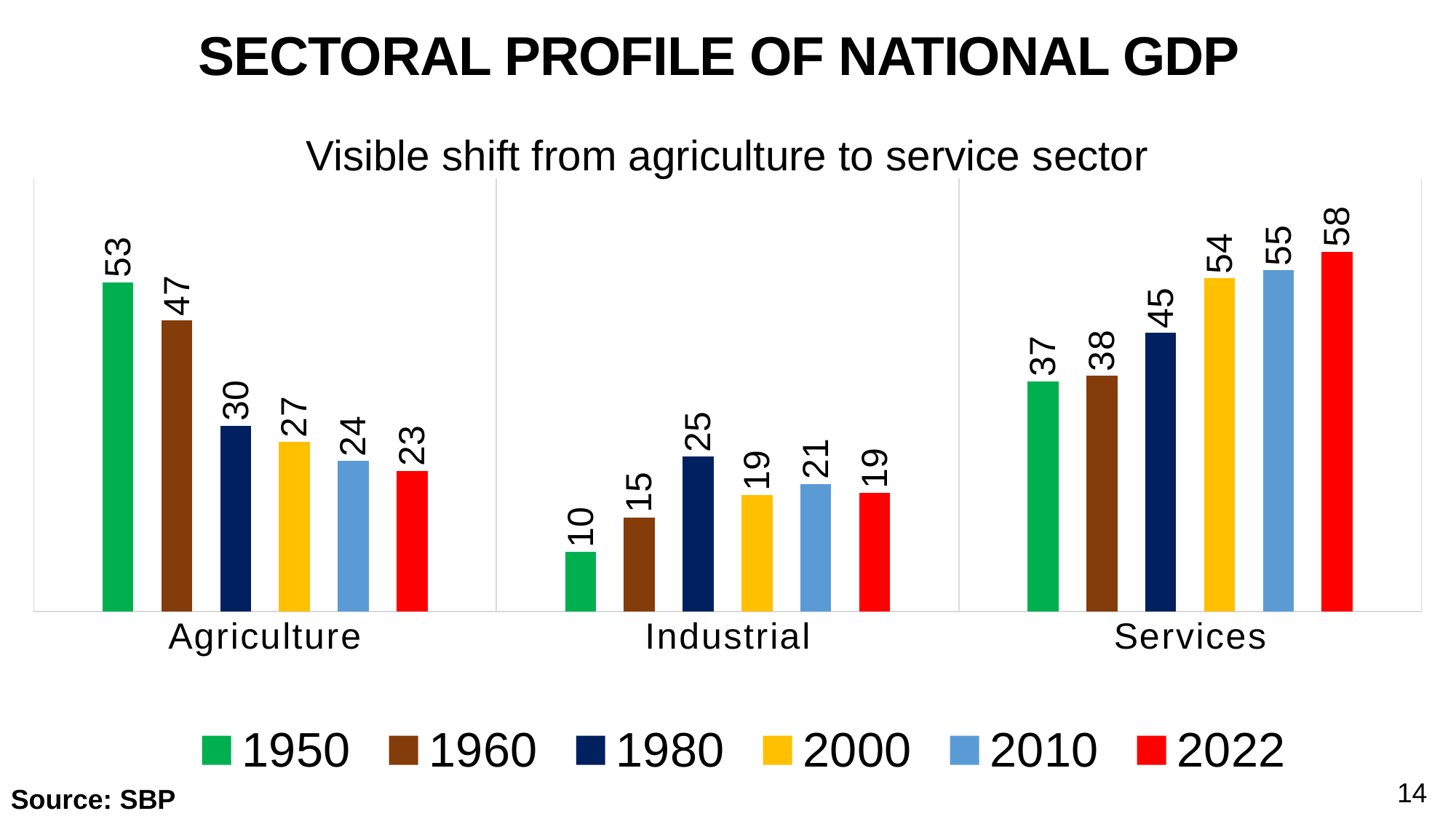
What is the value for Industrial in 1980? 25 How many sector categories are shown on the x axis? 3 Which year has the lowest value for Industrial? 1950 What is the value for Services in 2022? 58 What is the difference between the Agriculture values for 1950 and 2022? 30 Which is larger, the Services value for 1950 or the Agriculture value for 1950? Agriculture 1950 What kind of chart is shown on the slide? Bar chart Which year has the highest value for Services? 2022 How many series does the legend list? 6 What is the chart's title? Visible shift from agriculture to service sector What is the value for Agriculture in 1950? 53 Do the Agriculture values rise or fall from 1950 to 2022? Fall